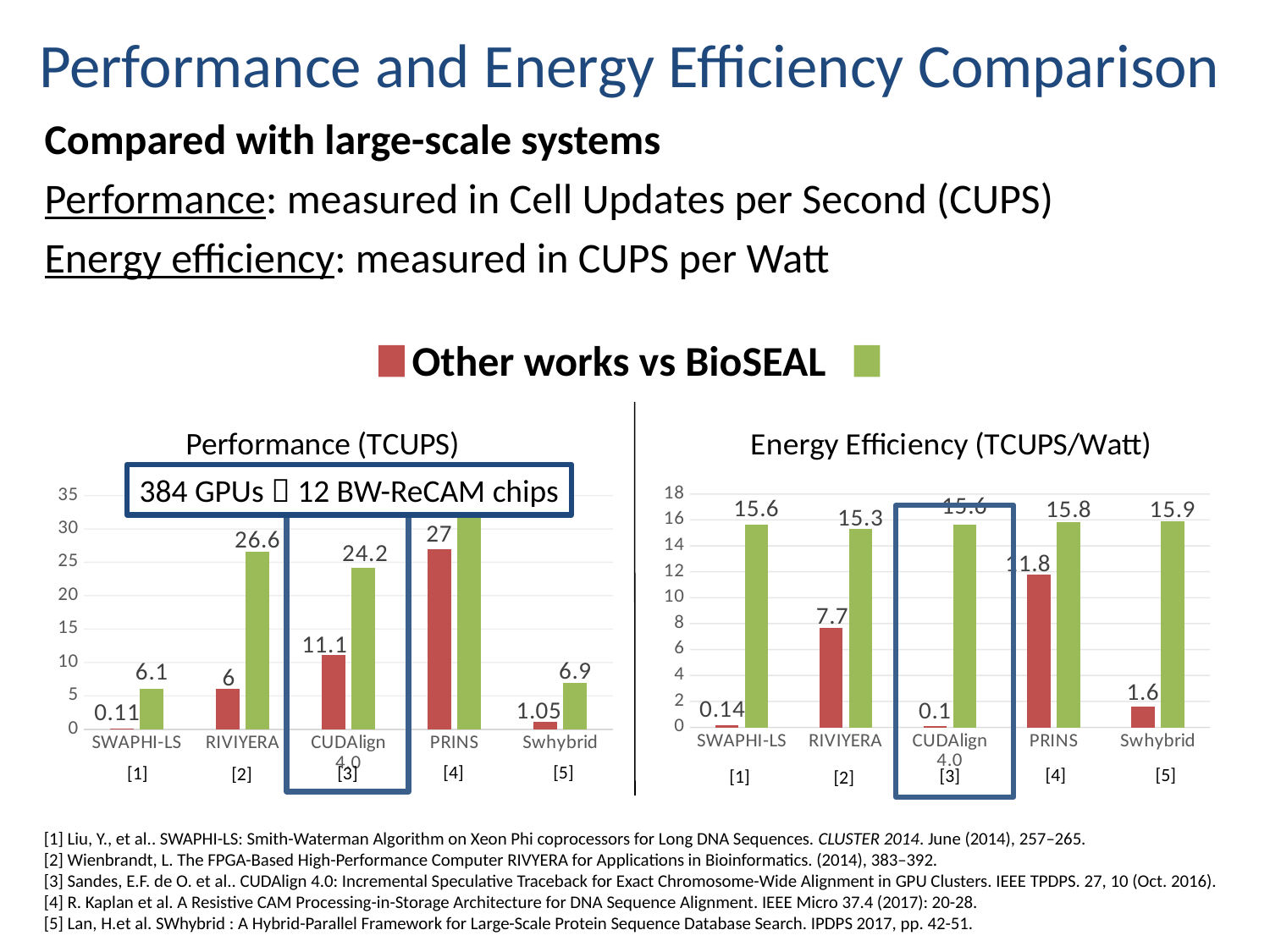
How many categories are shown on the x axis of the Energy Efficiency (TCUPS/Watt) chart? 5 In the Energy Efficiency (TCUPS/Watt) chart, which category has the lowest Other works value? CUDAlign 4.0 In the Performance (TCUPS) chart, what is the BioSEAL value for RIVIYERA? 26.6 In the Performance (TCUPS) chart, is the BioSEAL value for PRINS greater or less than 30? greater In the Energy Efficiency (TCUPS/Watt) chart, what is the difference between the BioSEAL and Other works values for RIVIYERA? 7.6 In the Performance (TCUPS) chart, which category has the highest Other works value? PRINS What kind of chart is the Performance (TCUPS) chart? Bar chart How many series does the legend list for the charts? 2 In the Performance (TCUPS) chart, what is the Other works value for CUDAlign 4.0? 11.1 In the Energy Efficiency (TCUPS/Watt) chart, what is the Other works value for PRINS? 11.8 In the Energy Efficiency (TCUPS/Watt) chart, what is the BioSEAL value for Swhybrid? 15.9 In the Performance (TCUPS) chart, what is the difference between the BioSEAL and Other works values for CUDAlign 4.0? 13.1